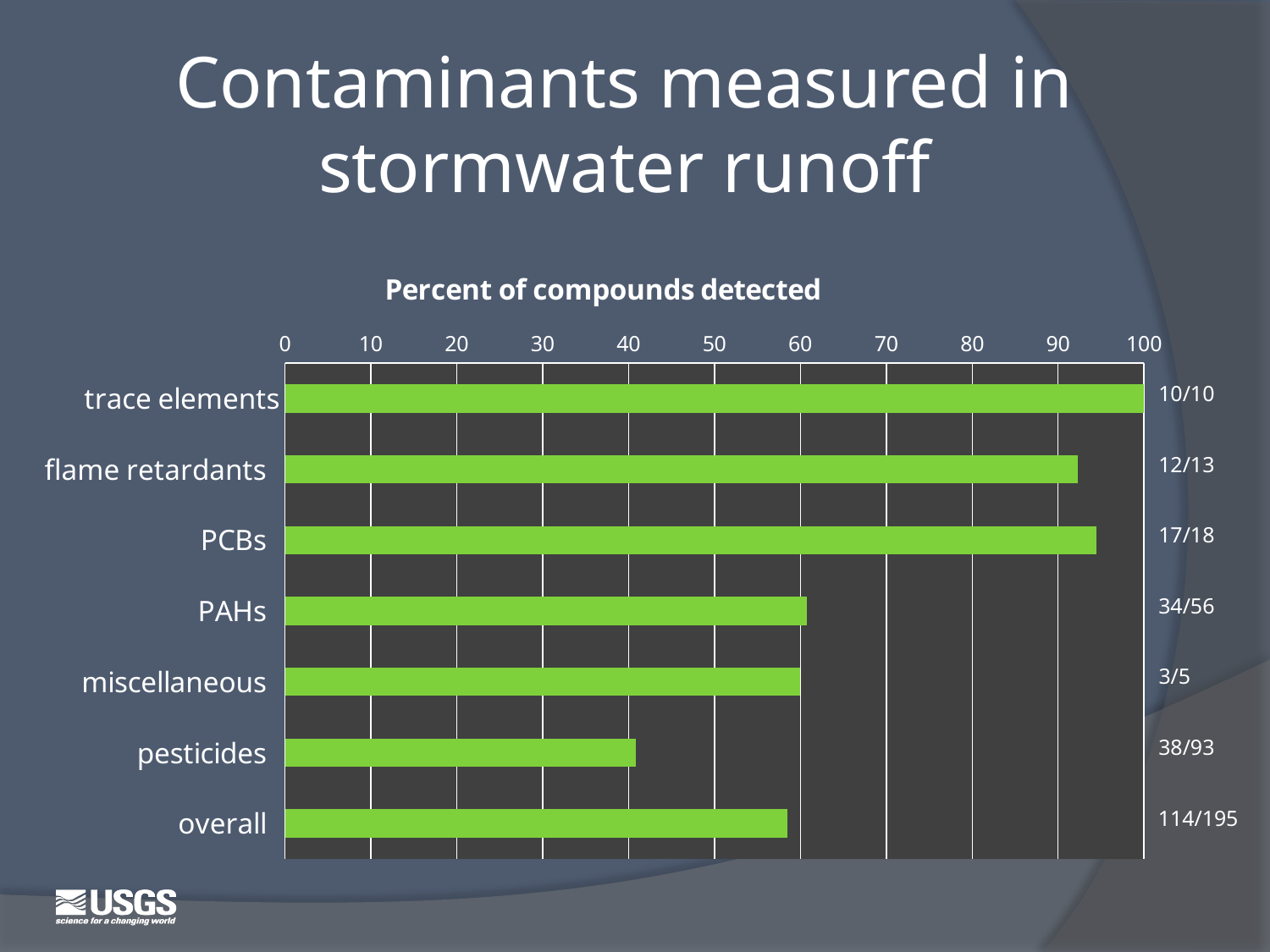
What fraction label is shown next to the pesticides bar? 38/93 What fraction label is shown next to the PAHs bar? 34/56 Is the value for PCBs greater or less than 90? greater Which category has the highest percent of compounds detected? trace elements What is the title of the chart? Percent of compounds detected How many categories are plotted in the chart? 7 Which has a higher percent of compounds detected, PCBs or PAHs? PCBs What kind of chart is shown on the slide? bar chart What percent of compounds were detected for trace elements? 100 Is the value for pesticides greater or less than 50? less What fraction label is shown next to the overall bar? 114/195 Which category has the lowest percent of compounds detected? pesticides